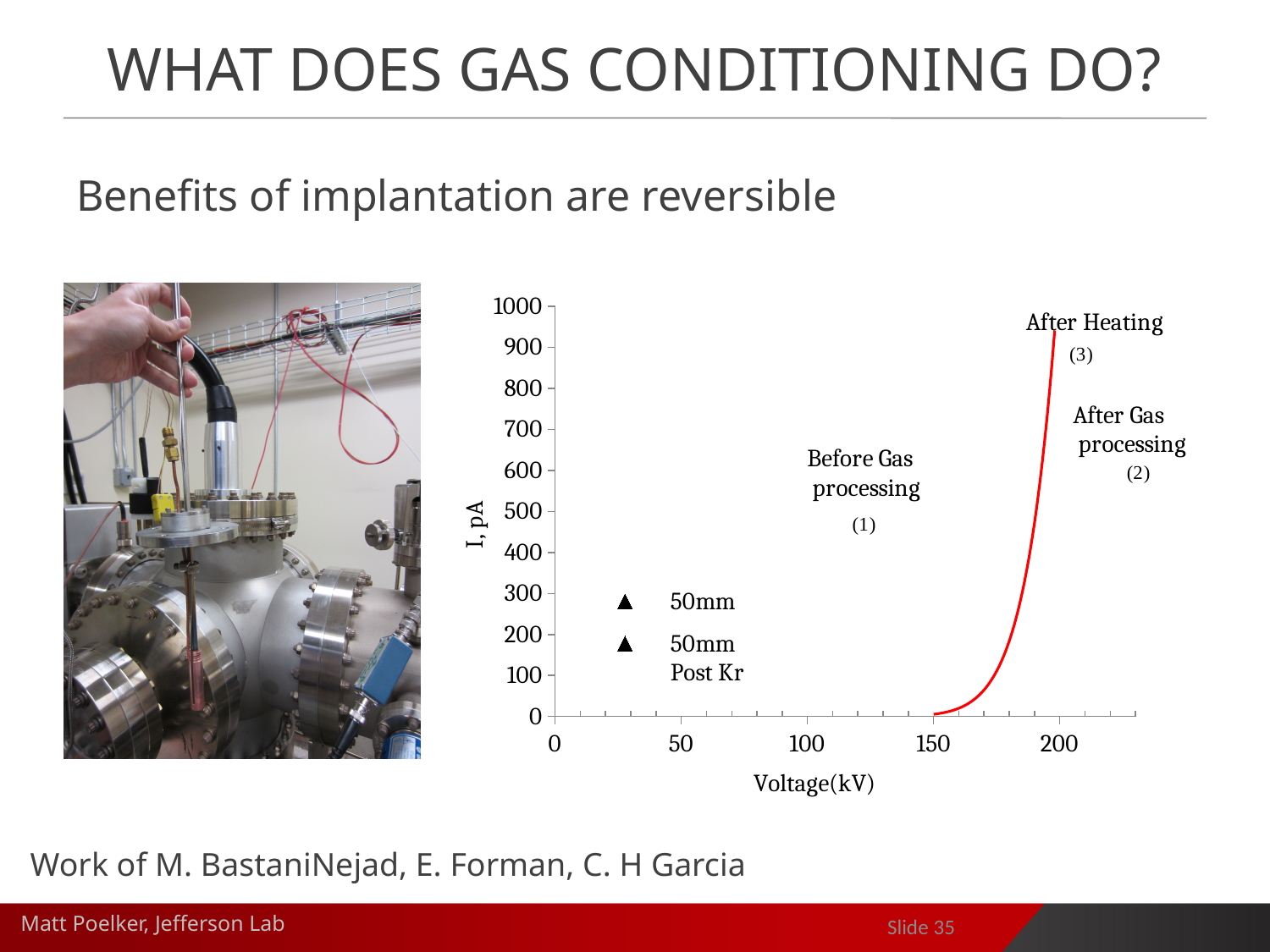
Is the current at 160 kV greater or less than 100 pA? less Does the current rise or fall as the voltage increases along the x axis? rise Is the current at 190 kV greater or less than 100 pA? greater How many series does the chart's legend list? 2 What is the highest value shown on the y axis of the chart? 1000 Is the voltage at which the red curve begins to rise above zero greater or less than 100 kV? greater What kind of chart is shown on the slide? line chart What is the label of the y axis of the chart? I, pA What is the label of the x axis of the chart? Voltage(kV)